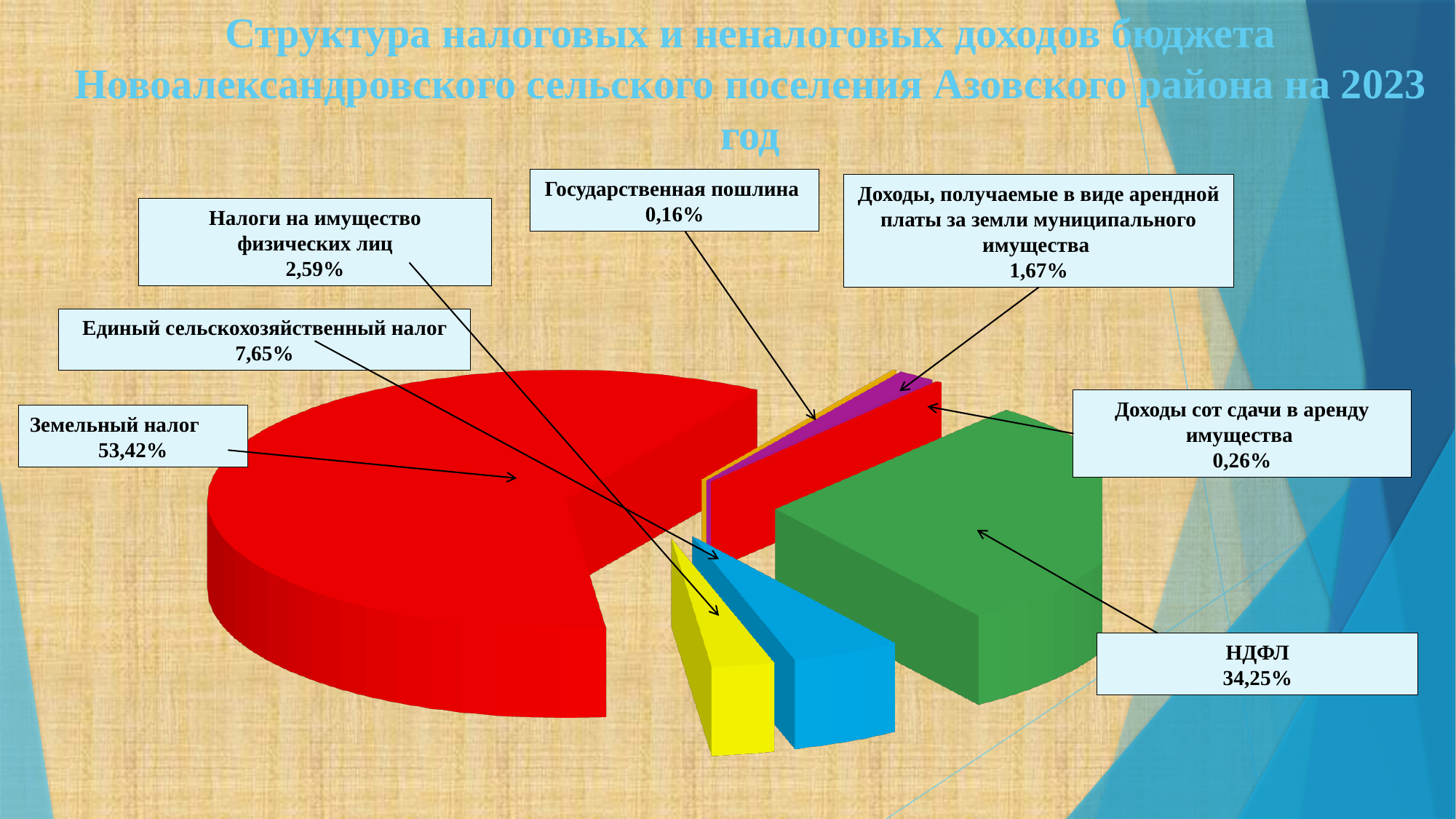
Which category has the largest share of the pie? Земельный налог Which is larger: Единый сельскохозяйственный налог or Налоги на имущество физических лиц? Единый сельскохозяйственный налог What percentage is shown for Государственная пошлина? 0,16% What is the value for Доходы сот сдачи в аренду имущества? 0,26% What is the value shown for НДФЛ? 34,25% How many categories are shown in the pie chart? 7 What percentage is shown for Единый сельскохозяйственный налог? 7,65% What is the value for Налоги на имущество физических лиц? 2,59% What kind of chart is shown on the slide? Pie chart What is the difference between the shares of Земельный налог and НДФЛ? 19,17% What share of revenue does Земельный налог account for? 53,42% Which category has the smallest share of the pie? Государственная пошлина